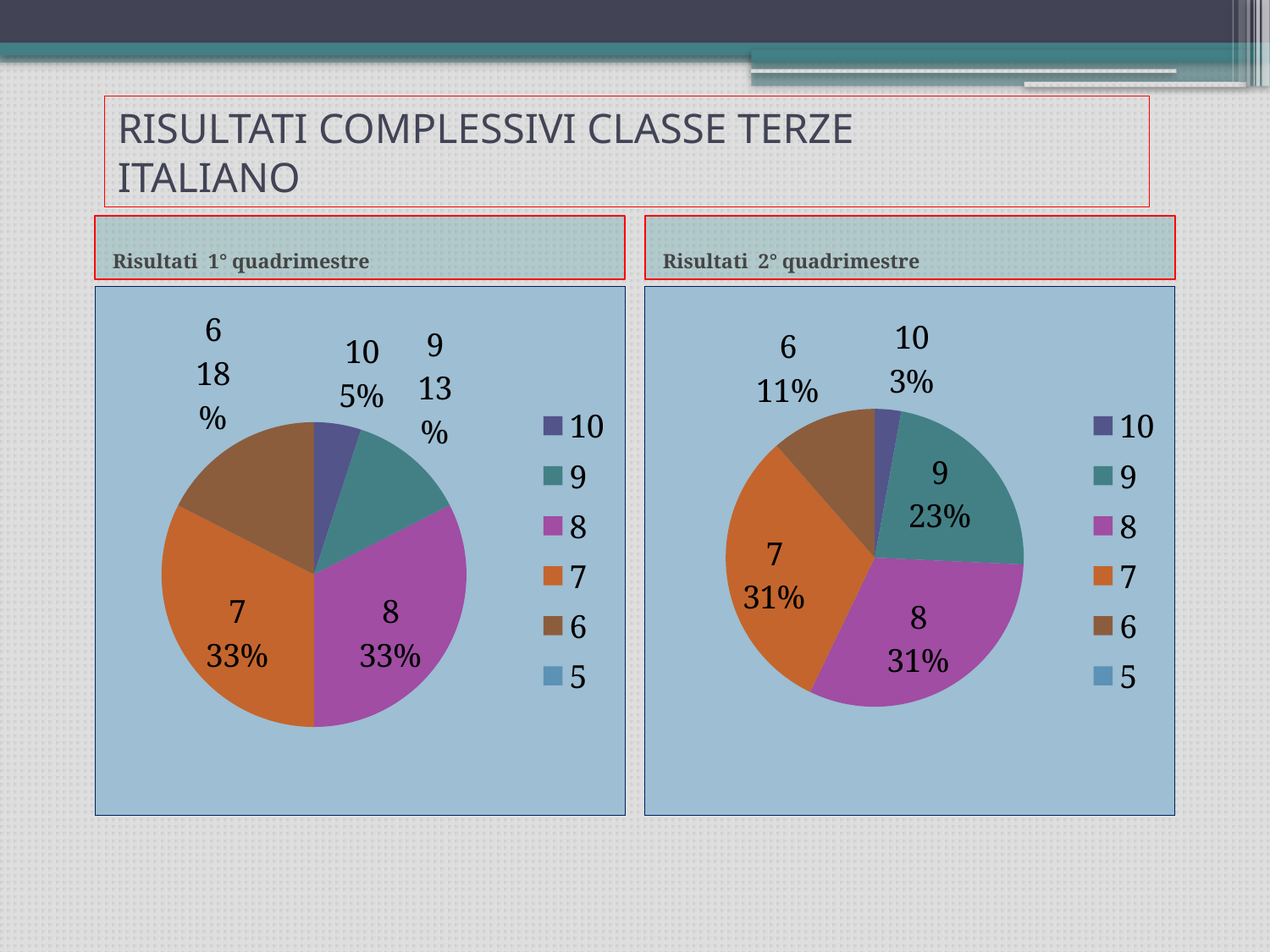
How many entries does the legend of the 'Risultati 2° quadrimestre' chart list? 6 In the 'Risultati 1° quadrimestre' chart, what share does grade 6 have? 18% In the 'Risultati 2° quadrimestre' chart, what share does grade 6 have? 11% In the 'Risultati 1° quadrimestre' chart, what colour is the slice for grade 8? Purple In the 'Risultati 2° quadrimestre' chart, what is the difference in percentage points between grade 9 and grade 6? 12 In the 'Risultati 2° quadrimestre' chart, which is larger: the share for grade 9 or the share for grade 6? 9 In the 'Risultati 1° quadrimestre' chart, which grade has the smallest slice? 10 In the 'Risultati 1° quadrimestre' chart, what is the difference in percentage points between grade 6 and grade 10? 13 In the 'Risultati 1° quadrimestre' chart, what share does grade 9 have? 13% In the 'Risultati 2° quadrimestre' chart, which grade has the smallest slice? 10 In the 'Risultati 2° quadrimestre' chart, what share does grade 9 have? 23% What kind of chart is the 'Risultati 1° quadrimestre' chart? Pie chart